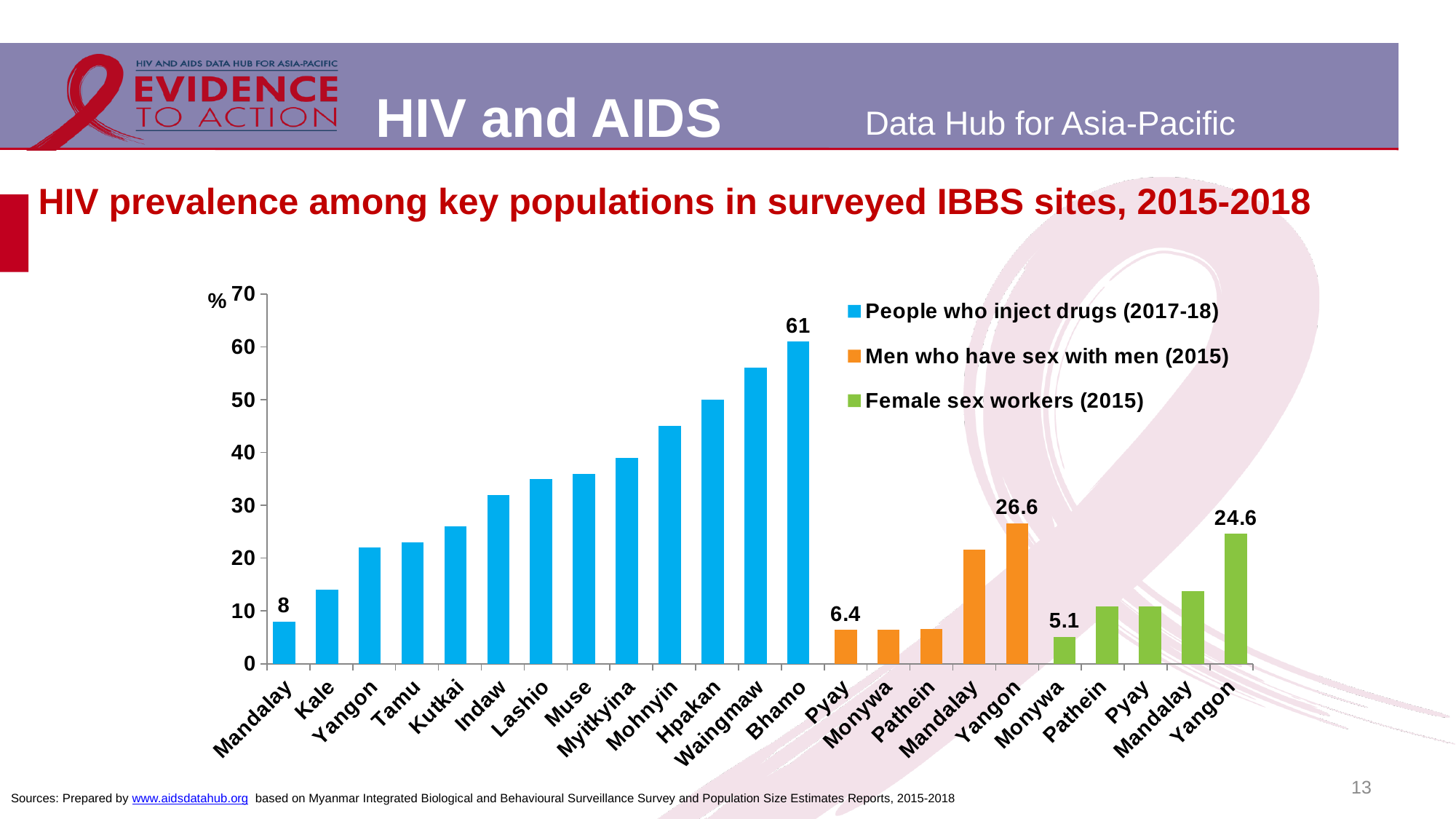
What kind of chart is shown on the slide? Bar chart What is the HIV prevalence among people who inject drugs in Bhamo? 61 What is the HIV prevalence among female sex workers in Monywa? 5.1 In Yangon, which is higher: HIV prevalence among men who have sex with men or among female sex workers? Men who have sex with men How many series does the legend list? 3 What is the difference between the HIV prevalence among people who inject drugs in Bhamo and in Mandalay? 53 What is the HIV prevalence among people who inject drugs in Mandalay? 8 Is the HIV prevalence among people who inject drugs in Hpakan greater or less than 40? greater What is the HIV prevalence among men who have sex with men in Pyay? 6.4 What is the HIV prevalence among men who have sex with men in Yangon? 26.6 Which site has the highest HIV prevalence among people who inject drugs? Bhamo Which site has the lowest HIV prevalence among female sex workers? Monywa